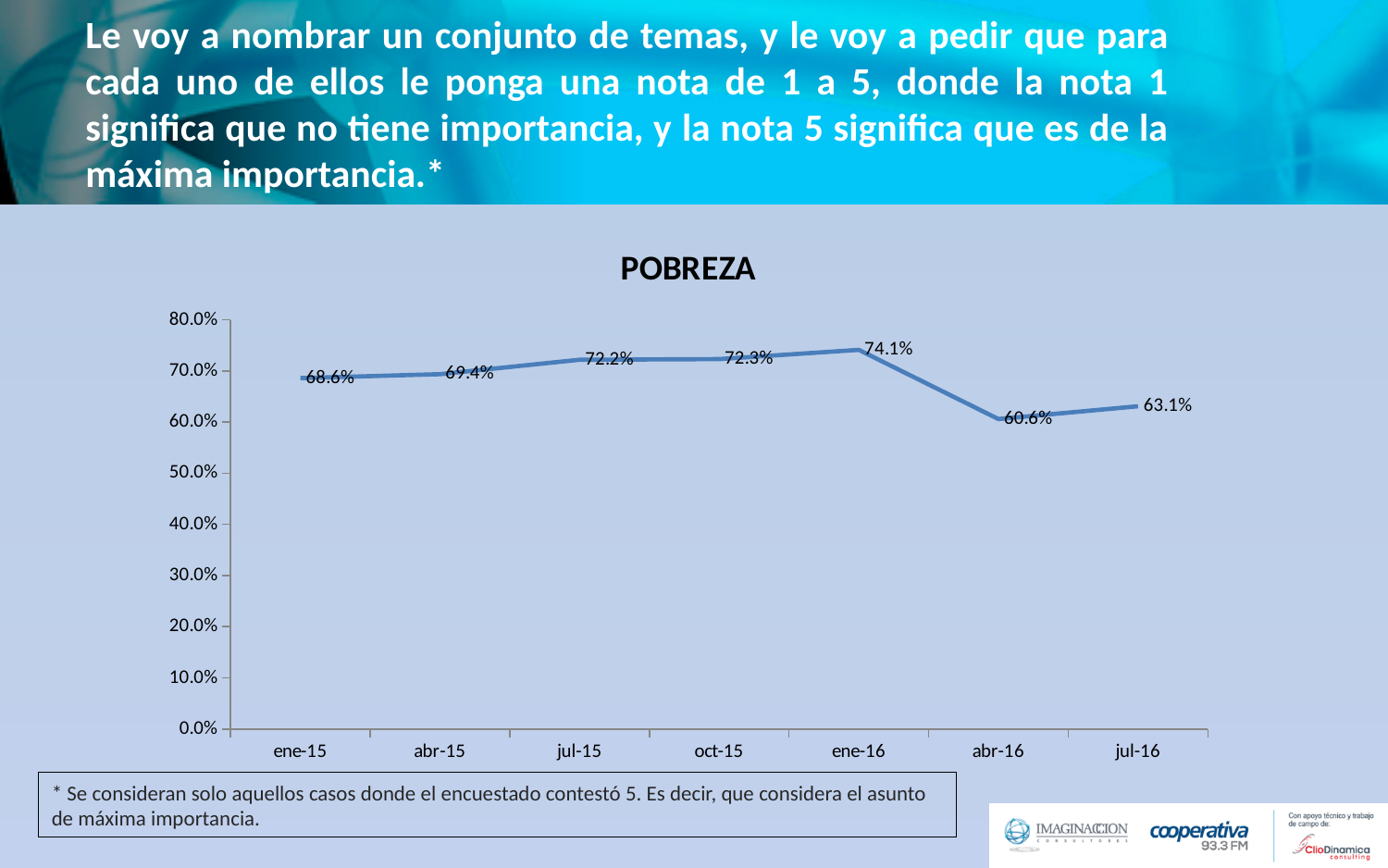
Which is larger in the POBREZA chart, the value for jul-15 or the value for jul-16? jul-15 Is the value for oct-15 in the POBREZA chart greater or less than 70.0%? greater What is the title of the chart on the slide? POBREZA What is the value for jul-16 in the POBREZA chart? 63.1% Does the value in the POBREZA chart rise or fall from ene-15 to ene-16? rise What is the value for abr-16 in the POBREZA chart? 60.6% How many data points are plotted in the POBREZA chart? 7 Which period has the highest value in the POBREZA chart? ene-16 What is the difference between the values for ene-16 and abr-16 in the POBREZA chart? 13.5% What kind of chart is the POBREZA chart? line chart What is the value for ene-15 in the POBREZA chart? 68.6% Which period has the lowest value in the POBREZA chart? abr-16